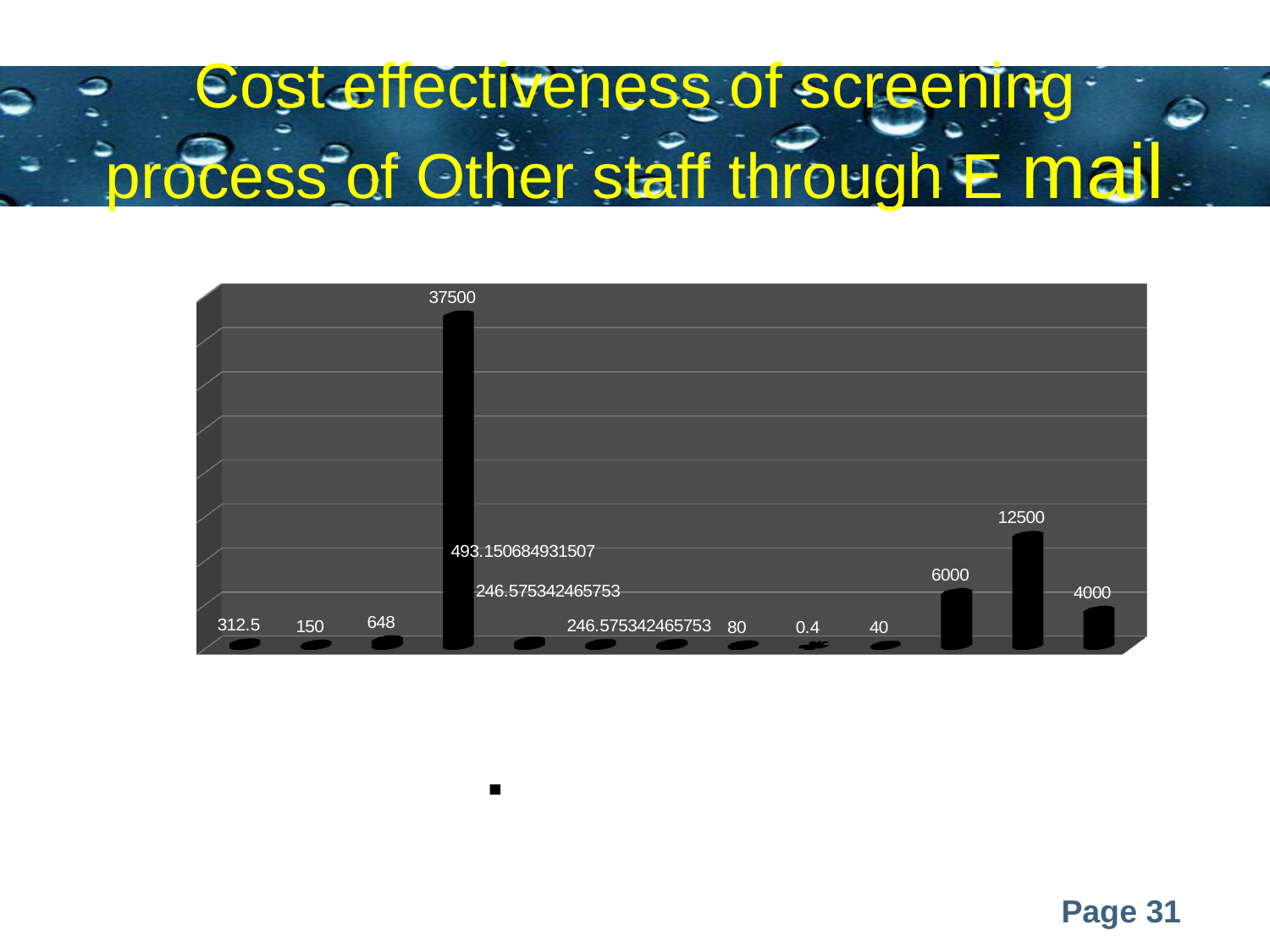
What is the difference between the tallest bar (37500) and the second bar from the right (12500)? 25000 Which is larger: the value of the rightmost bar or the value of the leftmost bar? the rightmost bar (4000) What is the value of the third bar from the right in the chart? 6000 What is the smallest value labelled in the chart? 0.4 What is the value of the second bar from the right in the chart? 12500 What is the value of the leftmost bar in the chart? 312.5 What is the difference between the second bar from the right (12500) and the third bar from the right (6000)? 6500 What is the value of the tallest bar in the chart? 37500 What is the title of the slide containing the chart? Cost effectiveness of screening process of Other staff through E mail What is the value of the rightmost bar in the chart? 4000 How many bars are plotted in the chart? 13 What kind of chart is shown on the slide? bar chart